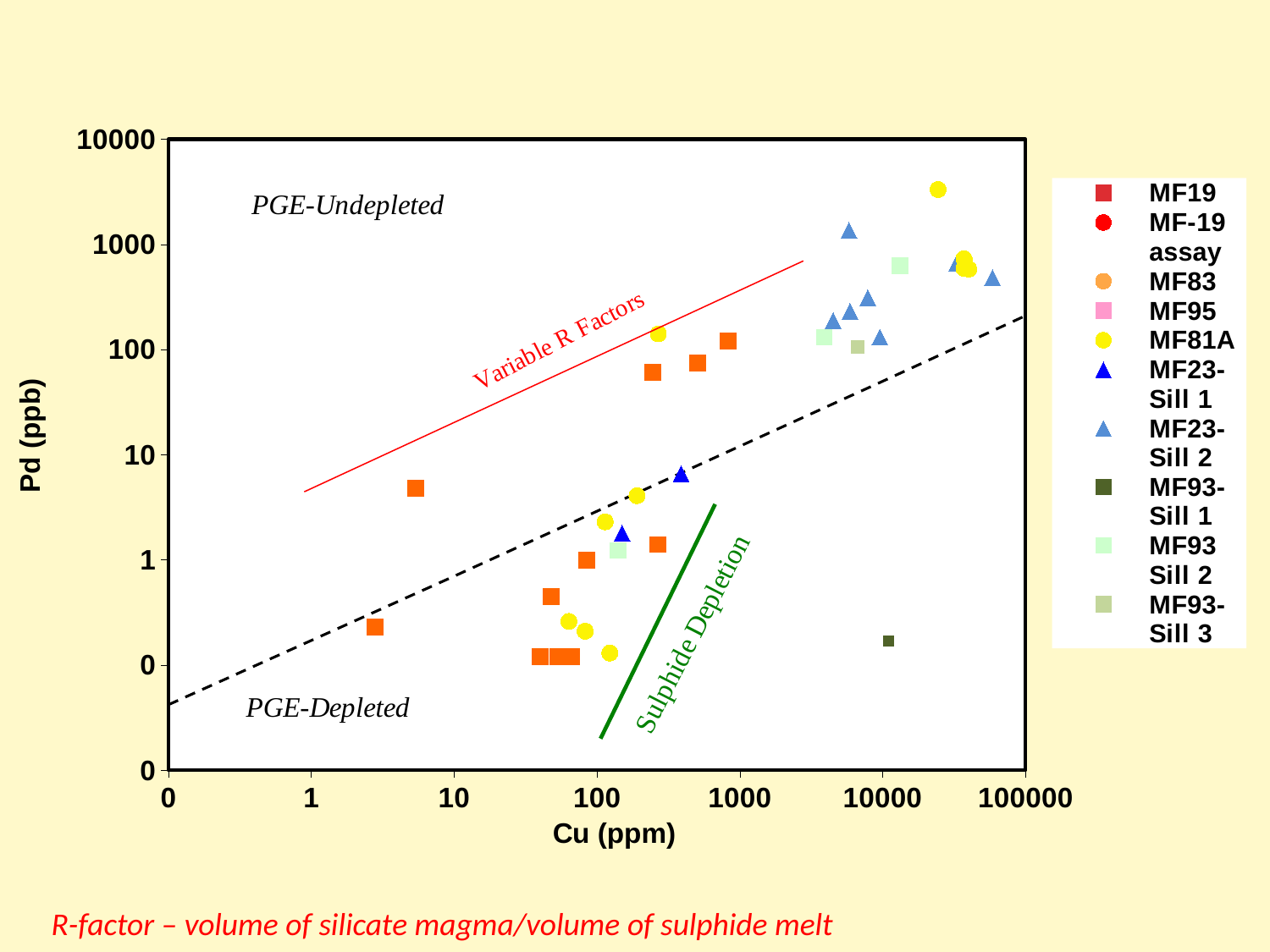
Is the Pd (ppb) value of the MF93-Sill 1 point greater or less than 1? less Is the Cu (ppm) value of the MF23-Sill 2 point with the highest Pd greater or less than 1000? greater What kind of chart is shown on the slide? scatter chart What is the label of the x axis? Cu (ppm) Is the Pd (ppb) value of the highest MF81A point greater or less than 1000? greater Which series has the point with the highest Pd (ppb) value? MF81A How many series does the legend list? 10 What is the label of the y axis? Pd (ppb)